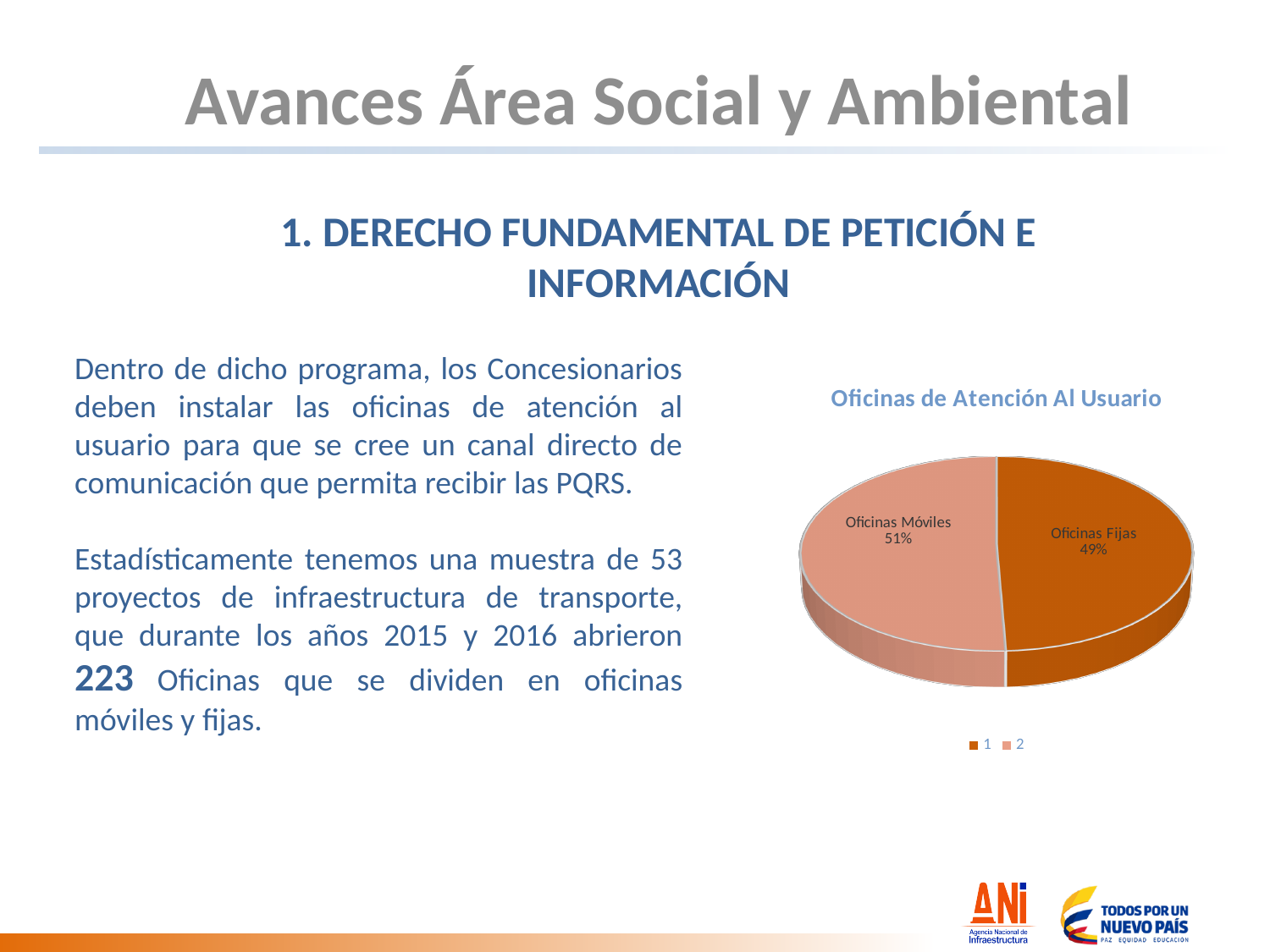
Which is larger, the share for Oficinas Móviles or the share for Oficinas Fijas? Oficinas Móviles Is the share for Oficinas Fijas greater or less than 50%? less What is the difference in percentage points between Oficinas Móviles and Oficinas Fijas? 2 percentage points What share of the pie is Oficinas Móviles? 51% What share of the pie is Oficinas Fijas? 49% What type of chart is shown on the slide? Pie chart How many slices does the pie chart have? 2 Which slice is the smallest in the pie chart? Oficinas Fijas How many entries does the legend list? 2 What is the title of the chart? Oficinas de Atención Al Usuario Which slice is the largest in the pie chart? Oficinas Móviles